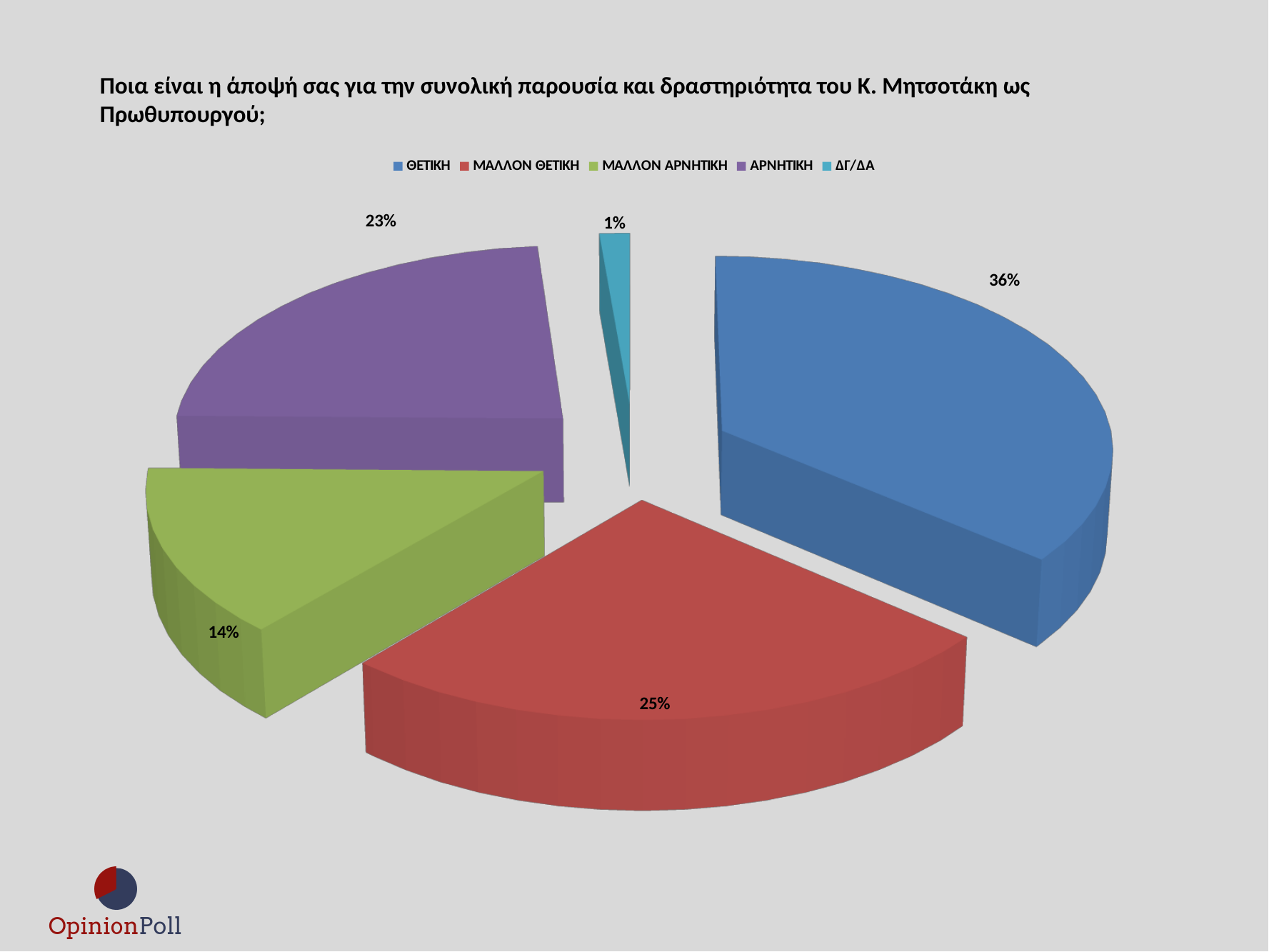
What type of chart is shown on the slide? Pie chart How many categories does the legend list? 5 What percentage of respondents answered ΑΡΝΗΤΙΚΗ? 23% What percentage of respondents answered ΜΑΛΛΟΝ ΑΡΝΗΤΙΚΗ? 14% What percentage of respondents answered ΔΓ/ΔΑ? 1% Which response category has the smallest share of the pie? ΔΓ/ΔΑ What colour is the slice for ΜΑΛΛΟΝ ΑΡΝΗΤΙΚΗ? Green What is the difference in percentage points between ΘΕΤΙΚΗ and ΑΡΝΗΤΙΚΗ? 13 Which response category has the largest share of the pie? ΘΕΤΙΚΗ What percentage of respondents answered ΜΑΛΛΟΝ ΘΕΤΙΚΗ? 25% What percentage of respondents answered ΘΕΤΙΚΗ? 36% Which is larger, the share for ΜΑΛΛΟΝ ΘΕΤΙΚΗ or the share for ΑΡΝΗΤΙΚΗ? ΜΑΛΛΟΝ ΘΕΤΙΚΗ